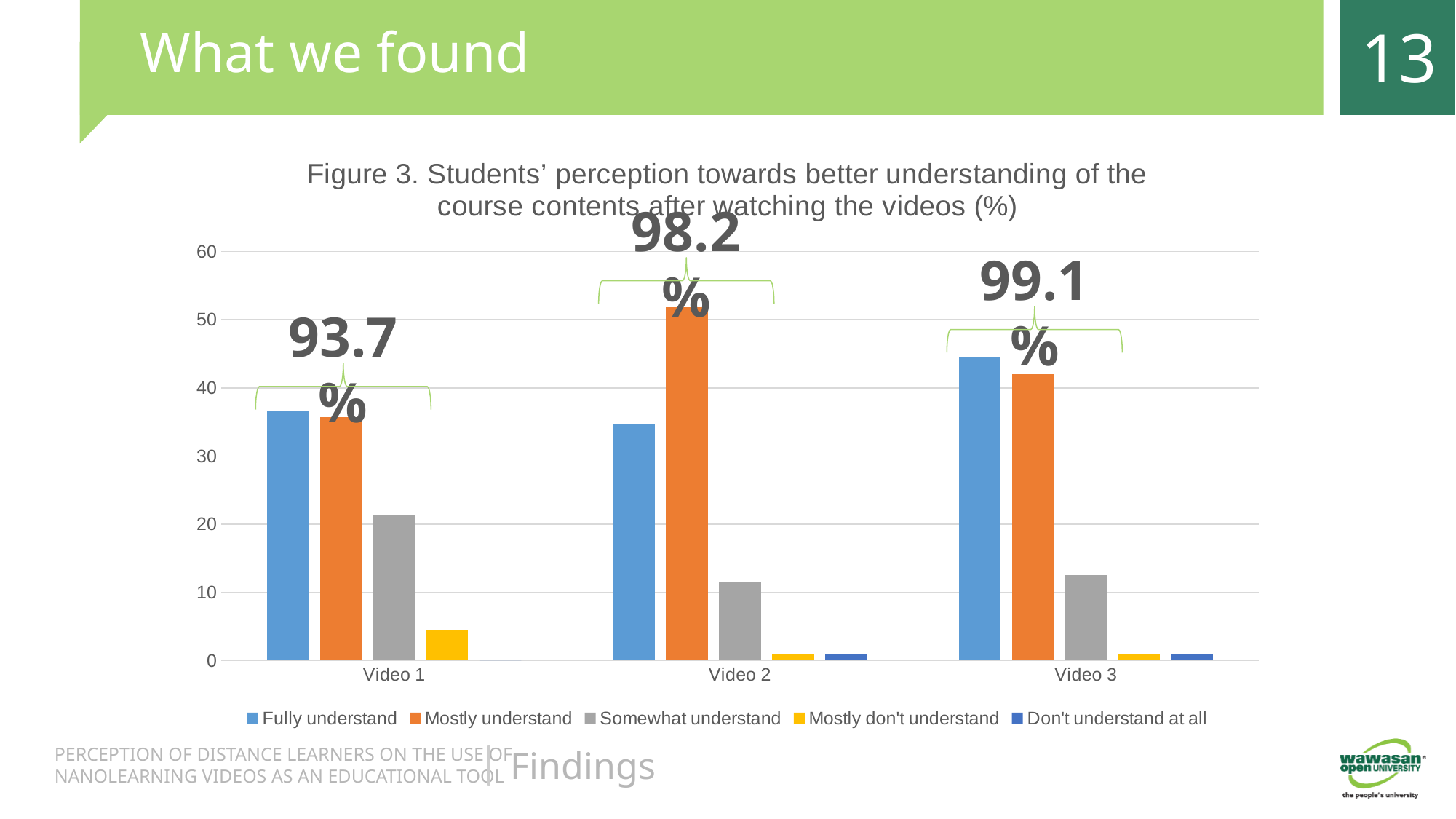
Is the value for Somewhat understand for Video 1 greater or less than 20? greater What percentage is annotated above the Video 3 group? 99.1% What percentage is annotated above the Video 1 group? 93.7% Which video has the highest Mostly understand bar? Video 2 Is the value for Fully understand for Video 3 greater or less than 40? greater Which is larger for Video 2: Fully understand or Mostly understand? Mostly understand Which video has the highest Fully understand bar? Video 3 How many video categories are shown on the x axis? 3 How many series does the legend list? 5 What kind of chart is shown on the slide? bar chart Is the value for Mostly understand for Video 2 greater or less than 50? greater What percentage is annotated above the Video 2 group? 98.2%